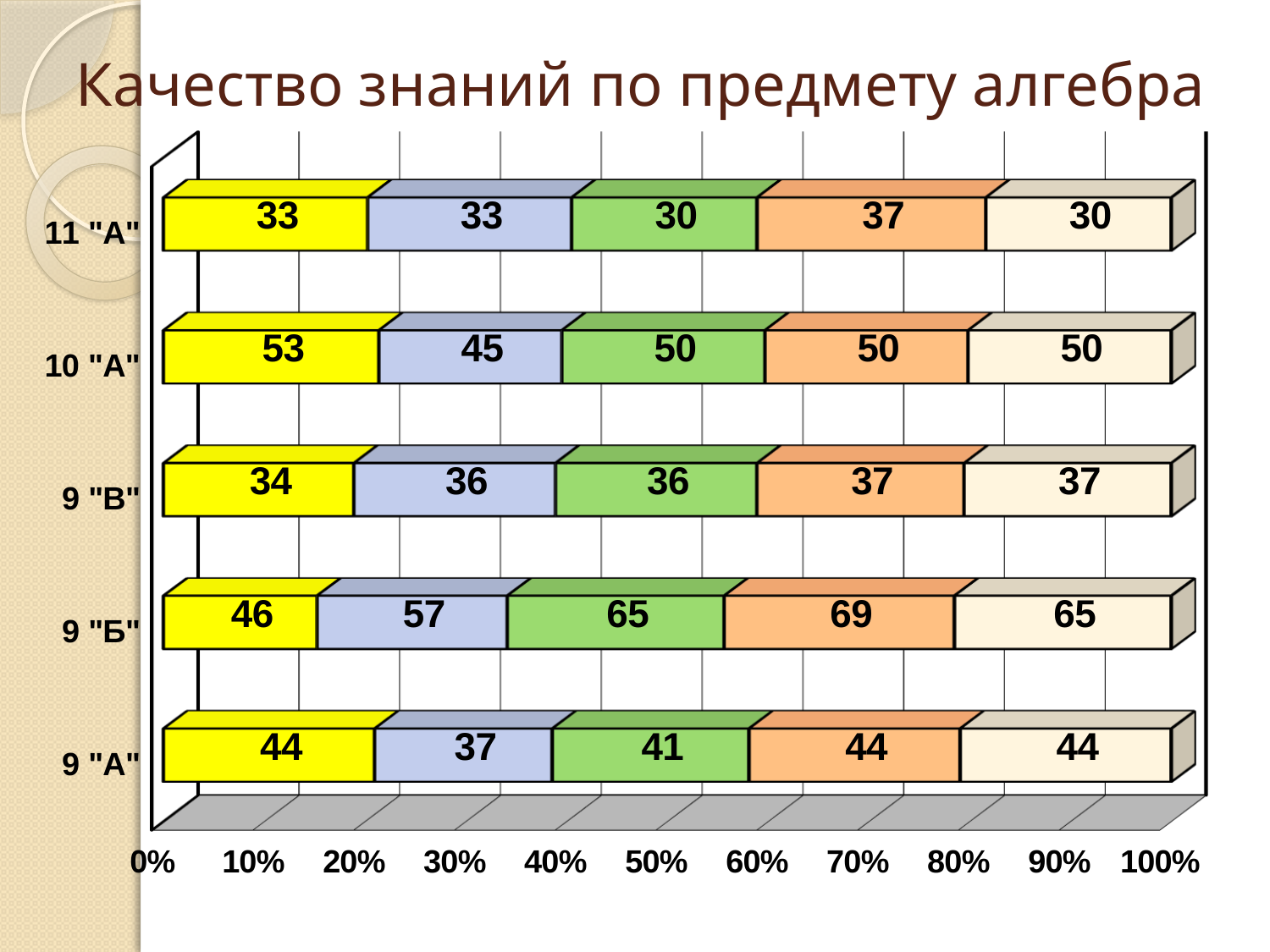
What is the value of the yellow (first) segment for 9 "Б"? 46 What colour is the first segment of each bar? Yellow What is the title of the chart? Качество знаний по предмету алгебра Which class has the highest value in the yellow (first) segment? 10 "А" Which class has the larger value in the blue (second) segment: 9 "Б" or 10 "А"? 9 "Б" How many segments does each bar in the chart consist of? 5 What is the difference between the green segment values for 9 "Б" and 9 "А"? 24 What kind of chart is shown on the slide? Stacked bar chart What is the value of the last (cream-coloured) segment for 11 "А"? 30 How many classes (categories) are shown on the vertical axis of the chart? 5 What is the value of the green (third) segment for 10 "А"? 50 Which class has the lowest value in the orange (fourth) segment? 9 "В" and 11 "А" (both 37)